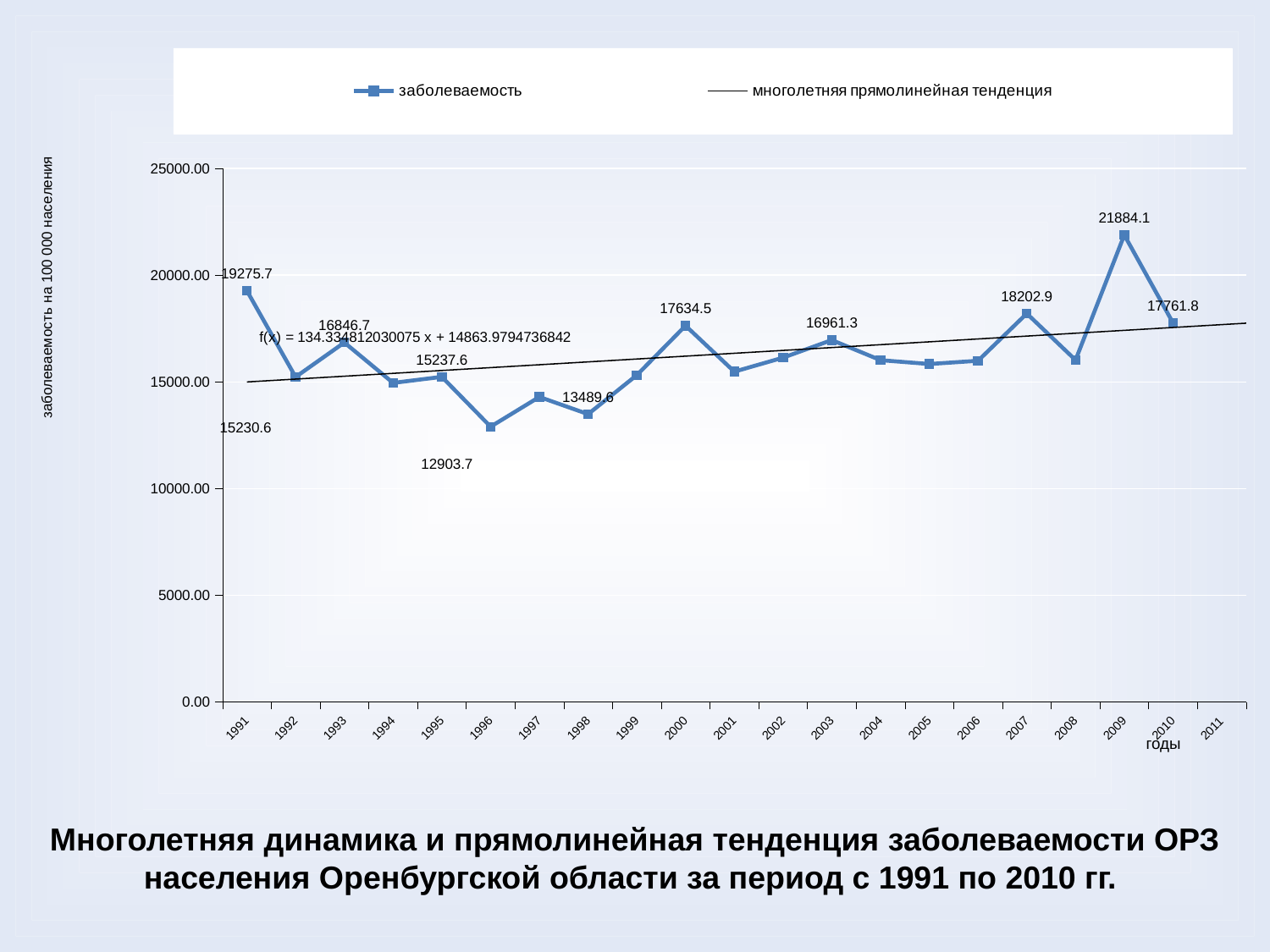
Which year has the lowest value? 1996 Is the value for 2002 greater or less than 15000? greater What kind of chart is this? line chart What is the difference between the values for 2009 and 2010? 4122.3 What is the value for 2007? 18202.9 What is the value for 2009? 21884.1 What is the value for 1996? 12903.7 Is the value for 1997 greater or less than 15000? less Which year has the highest value? 2009 How many series does the legend list? 2 Which is larger, the value for 2000 or the value for 2003? 2000 What is the value for 1991? 19275.7